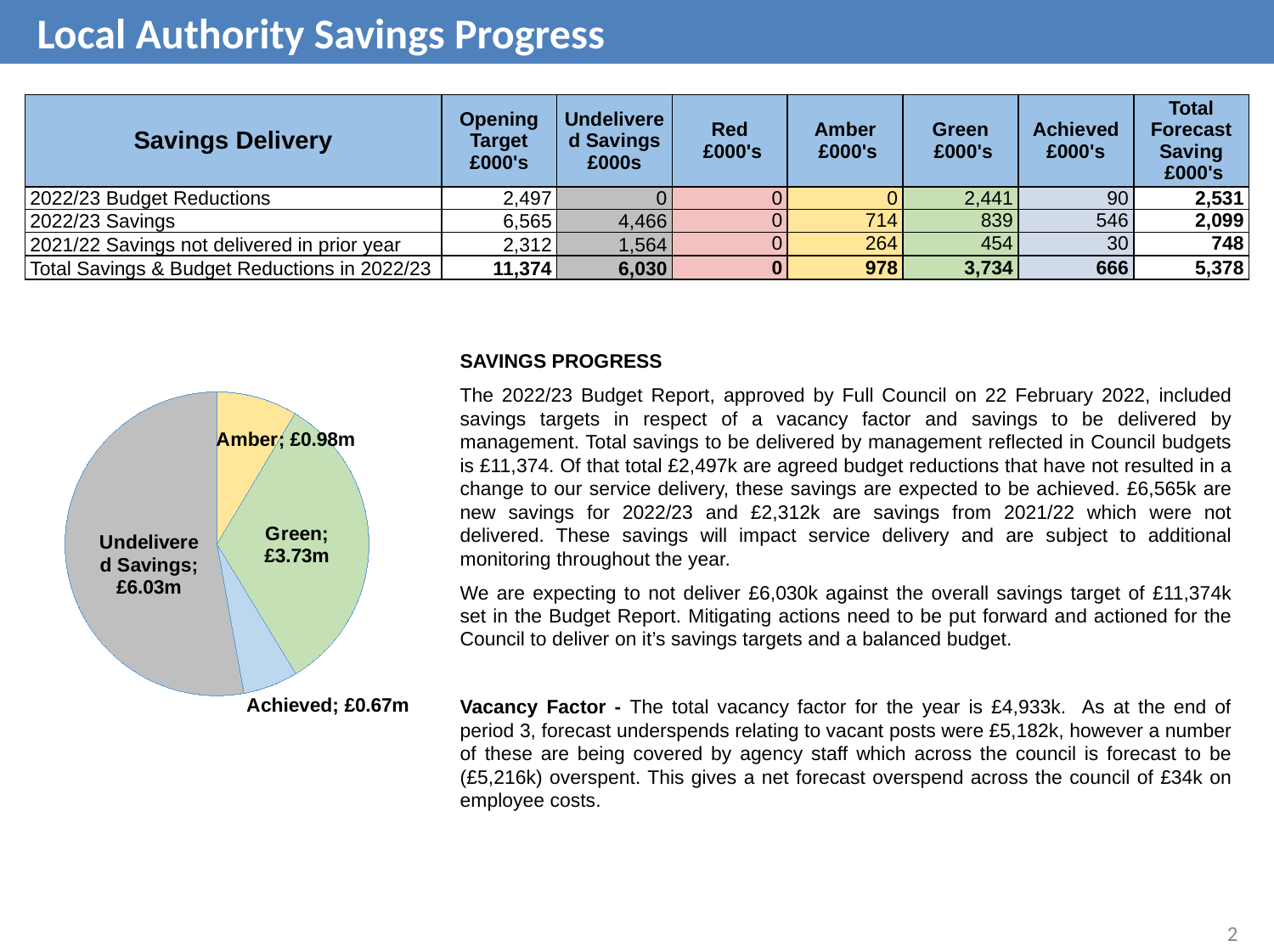
What is the value of the Amber slice in the pie chart? £0.98m Which slice of the pie chart is the largest? Undelivered Savings What colour is the Undelivered Savings slice in the pie chart? grey In the pie chart, which is larger: the Green slice or the Amber slice? Green How many slices does the pie chart have? 4 What is the difference between the Undelivered Savings slice and the Green slice in the pie chart? £2.30m What is the value of the Green slice in the pie chart? £3.73m What kind of chart is shown on the slide? pie chart What is the value of the Achieved slice in the pie chart? £0.67m What is the value of the Undelivered Savings slice in the pie chart? £6.03m Which slice of the pie chart is the smallest? Achieved What is the difference between the Amber slice and the Achieved slice in the pie chart? £0.31m